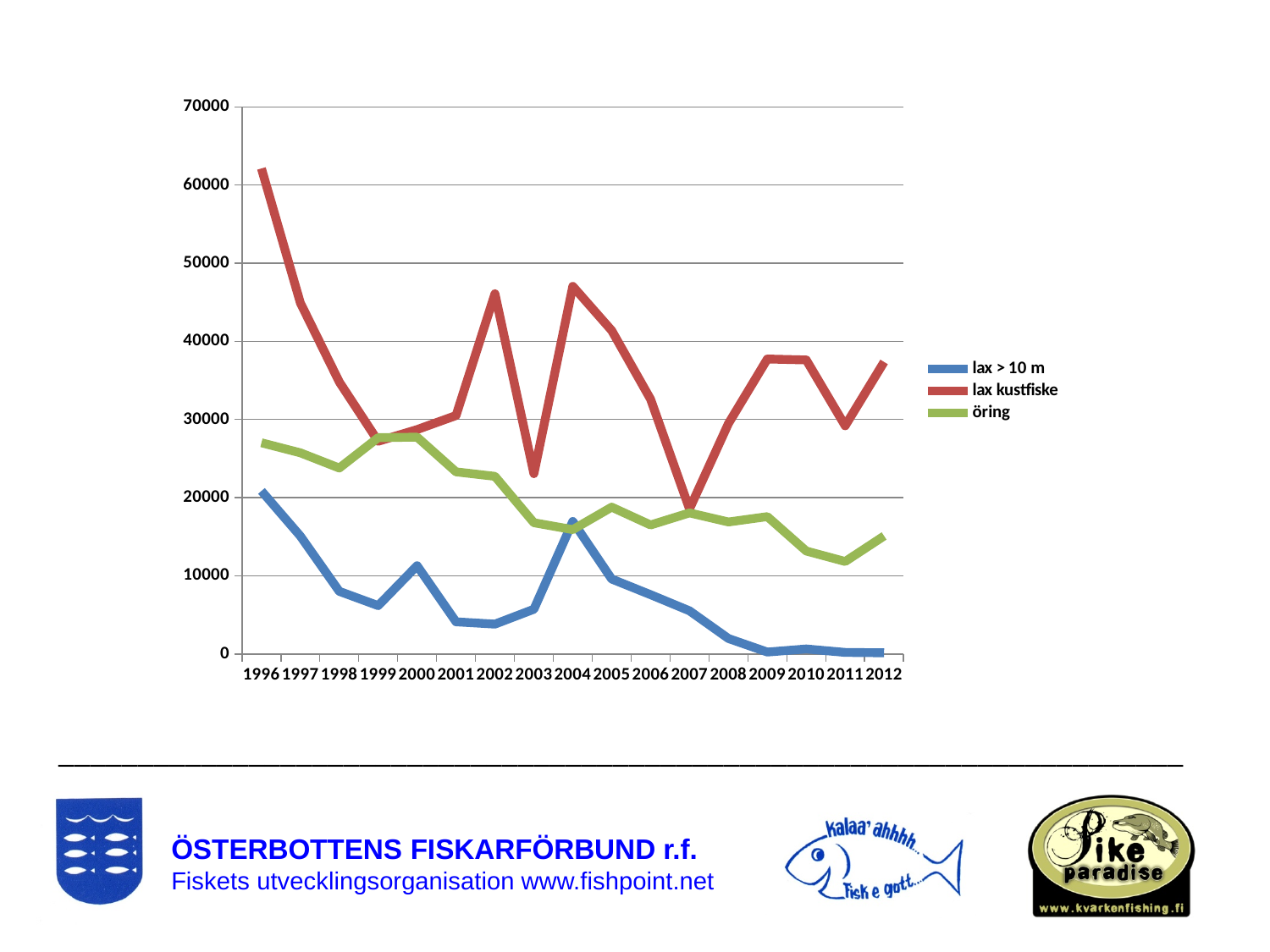
How many series does the legend list? 3 How many years are plotted along the x axis? 17 Does the value for lax > 10 m generally rise or fall from 1996 to 2012? fall In 2012, which is larger: lax kustfiske or öring? lax kustfiske In which year is the value for lax kustfiske highest? 1996 Is the value for lax kustfiske in 2007 greater or less than 30000? less What colour is the line for öring? green Is the value for lax > 10 m in 2009 greater or less than 10000? less In which year is the value for lax kustfiske lowest? 2007 Is the value for öring in 2012 greater or less than 20000? less What kind of chart is shown on the slide? line chart